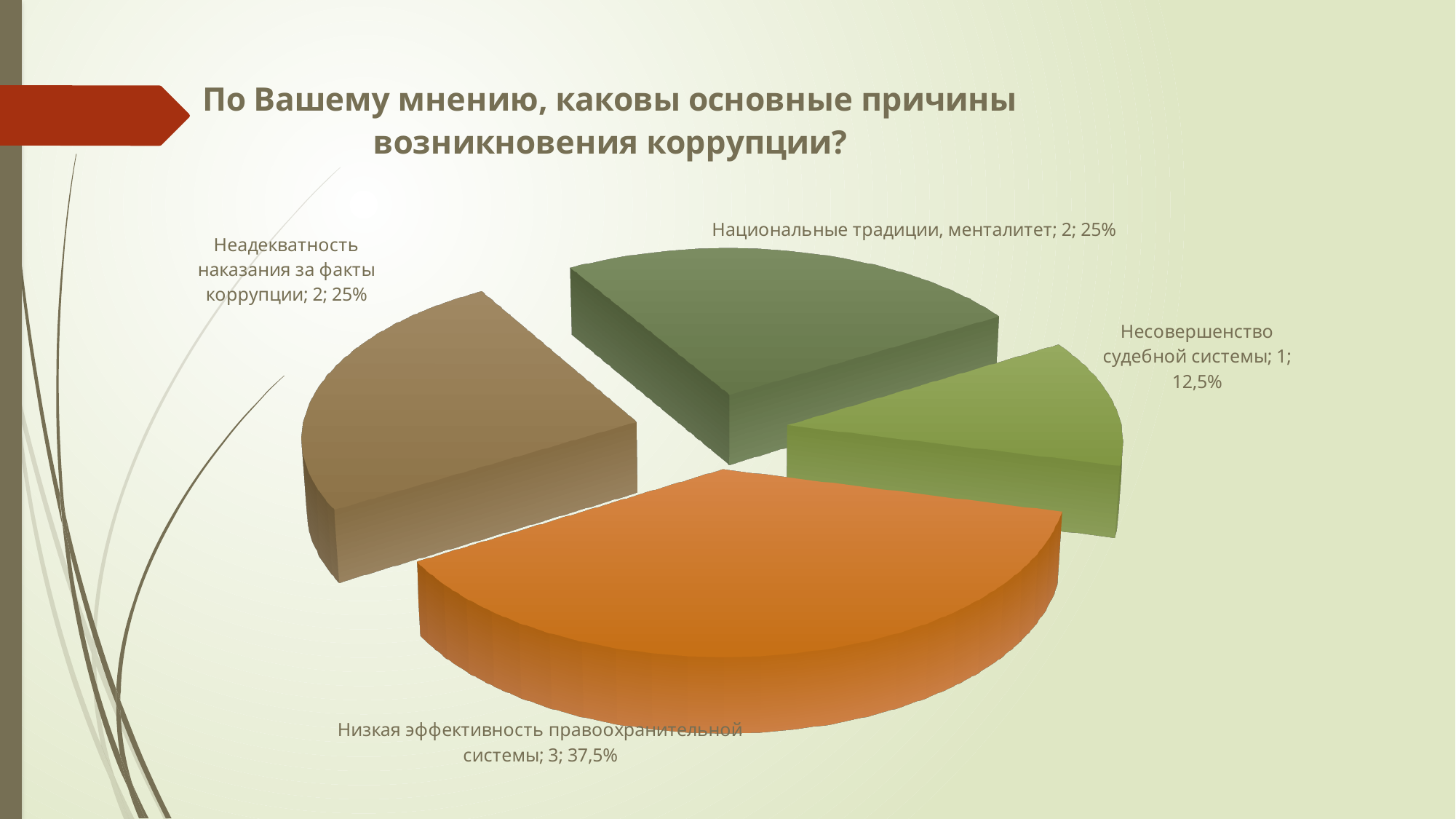
What is the title of the chart? По Вашему мнению, каковы основные причины возникновения коррупции? What is the value for 'Низкая эффективность правоохранительной системы'? 3 Which category has the smallest slice? Несовершенство судебной системы What kind of chart is shown on the slide? pie chart Which is larger: the value for 'Неадекватность наказания за факты коррупции' or for 'Несовершенство судебной системы'? Неадекватность наказания за факты коррупции How many slices does the pie chart have? 4 Which category has the largest slice? Низкая эффективность правоохранительной системы What percentage share does 'Низкая эффективность правоохранительной системы' have? 37,5% What is the total of all the values shown in the pie chart? 8 What percentage share does 'Несовершенство судебной системы' have? 12,5% What is the difference between the values for 'Низкая эффективность правоохранительной системы' and 'Несовершенство судебной системы'? 2 What is the value for 'Национальные традиции, менталитет'? 2